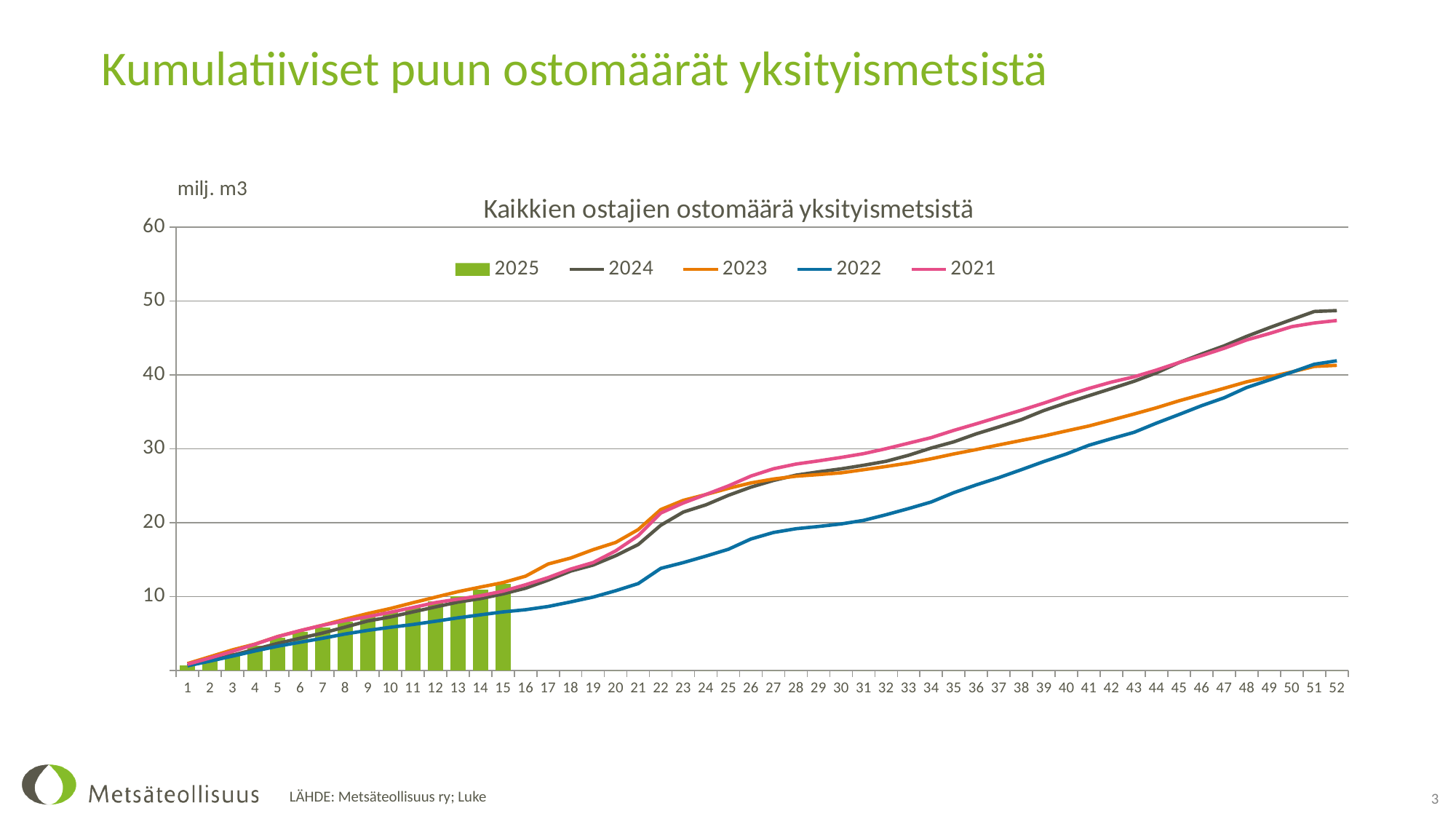
For how many weeks are bars plotted for the 2025 series? 15 Which year's line is highest at week 52? 2024 What kind of chart is shown on the slide? A combination of a bar chart and a line chart What unit is shown on the y axis of the chart? milj. m3 How many series does the legend list? 5 At week 40, which is larger, the value for 2023 or the value for 2022? 2023 Is the value for 2022 at week 26 greater or less than 20? less How many weeks are shown on the x axis? 52 Which year's line is lowest at week 30? 2022 Do the values of the 2024 line rise or fall along the x axis? Rise Is the value for 2022 at week 52 greater or less than 40? greater Is the 2025 bar at week 15 greater or less than 10? greater